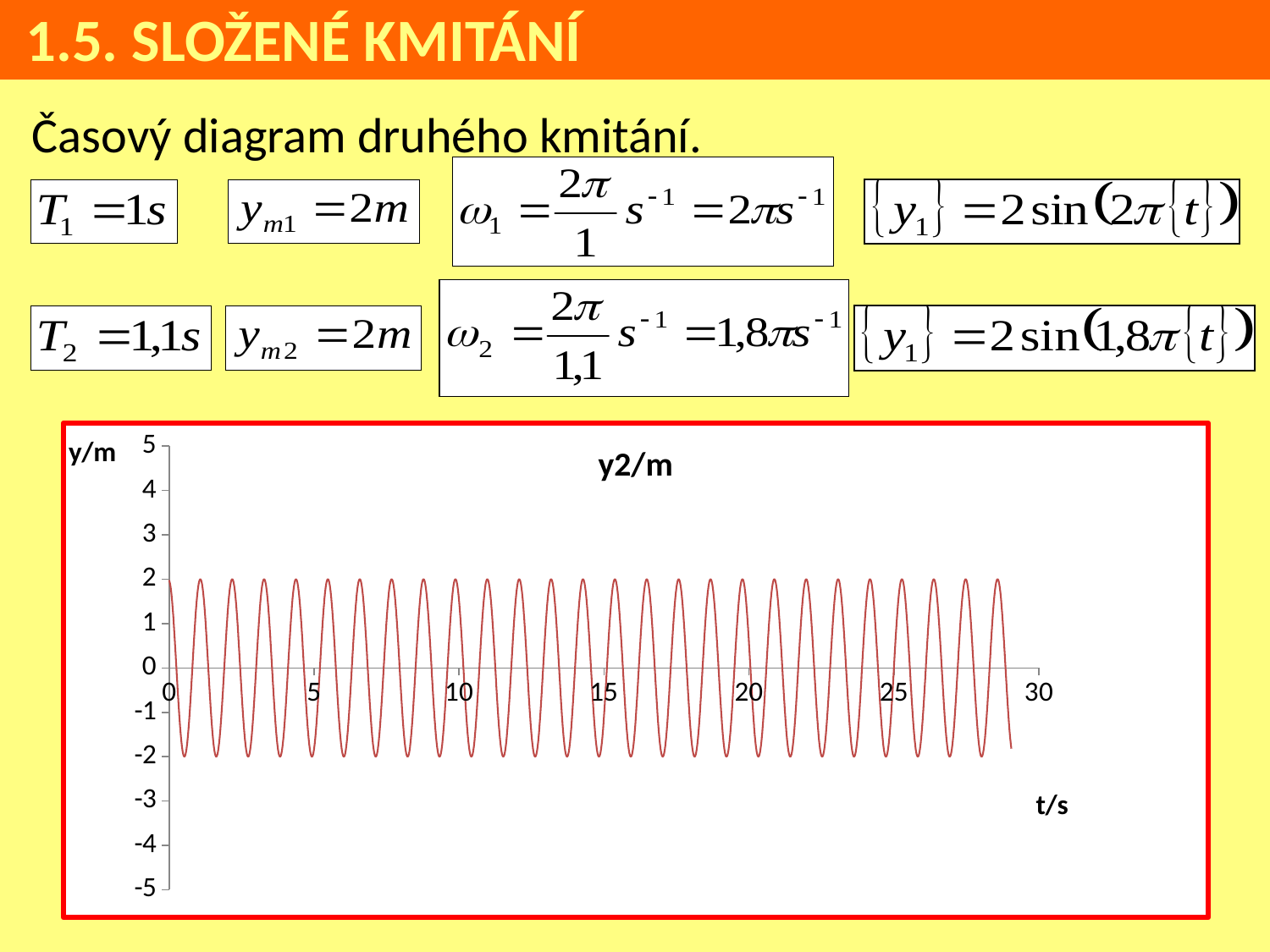
What is the label of the vertical axis of the chart? y/m What kind of chart is shown on the slide? line chart What is the value of the curve at t = 0? 2 What is the title of the chart? y2/m What is the lowest value reached by the plotted curve? -2 What is the largest value shown on the vertical axis? 5 What is the highest value reached by the plotted curve? 2 Does the curve steadily rise, steadily fall, or oscillate along the t axis? oscillate Is the minimum value of the curve greater or less than -3? greater Is the maximum value of the curve greater or less than 3? less What is the difference between the highest and lowest values of the curve? 4